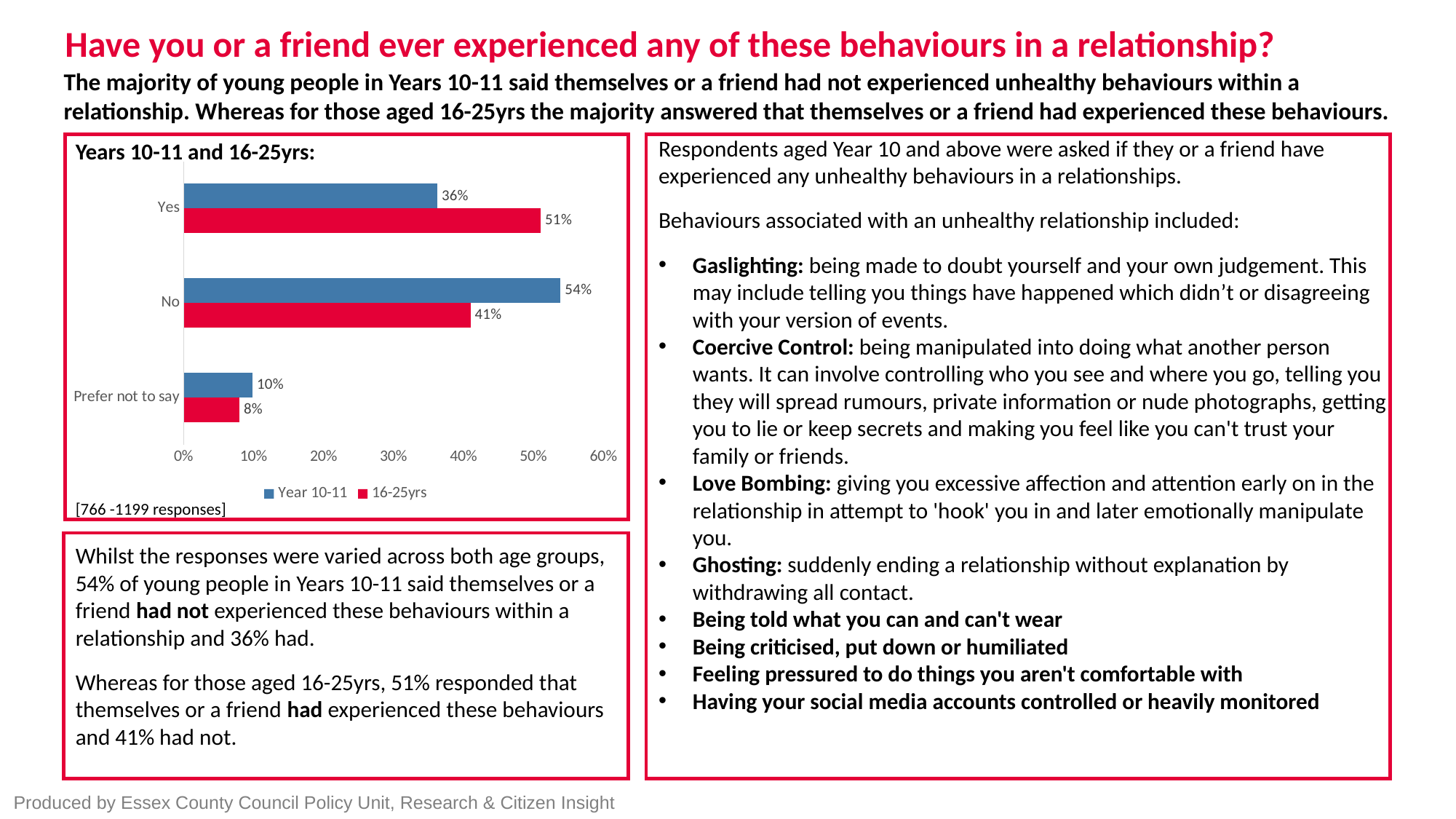
For the "No" response, which series has the larger value: Year 10-11 or 16-25yrs? Year 10-11 What percentage of 16-25yrs respondents answered "Prefer not to say"? 8% Is the Year 10-11 value for "No" greater or less than 50%? greater What percentage of 16-25yrs respondents answered "No"? 41% Which response category has the lowest value for the 16-25yrs series? Prefer not to say How many response categories are shown on the chart? 3 Which response category has the highest value for the Year 10-11 series? No What is the difference between the 16-25yrs and Year 10-11 values for "Yes"? 15 percentage points How many series does the chart legend list? 2 Which colour represents the 16-25yrs series in the chart? Red What type of chart is shown on the slide? Bar chart What percentage of Year 10-11 respondents answered "Yes"? 36%